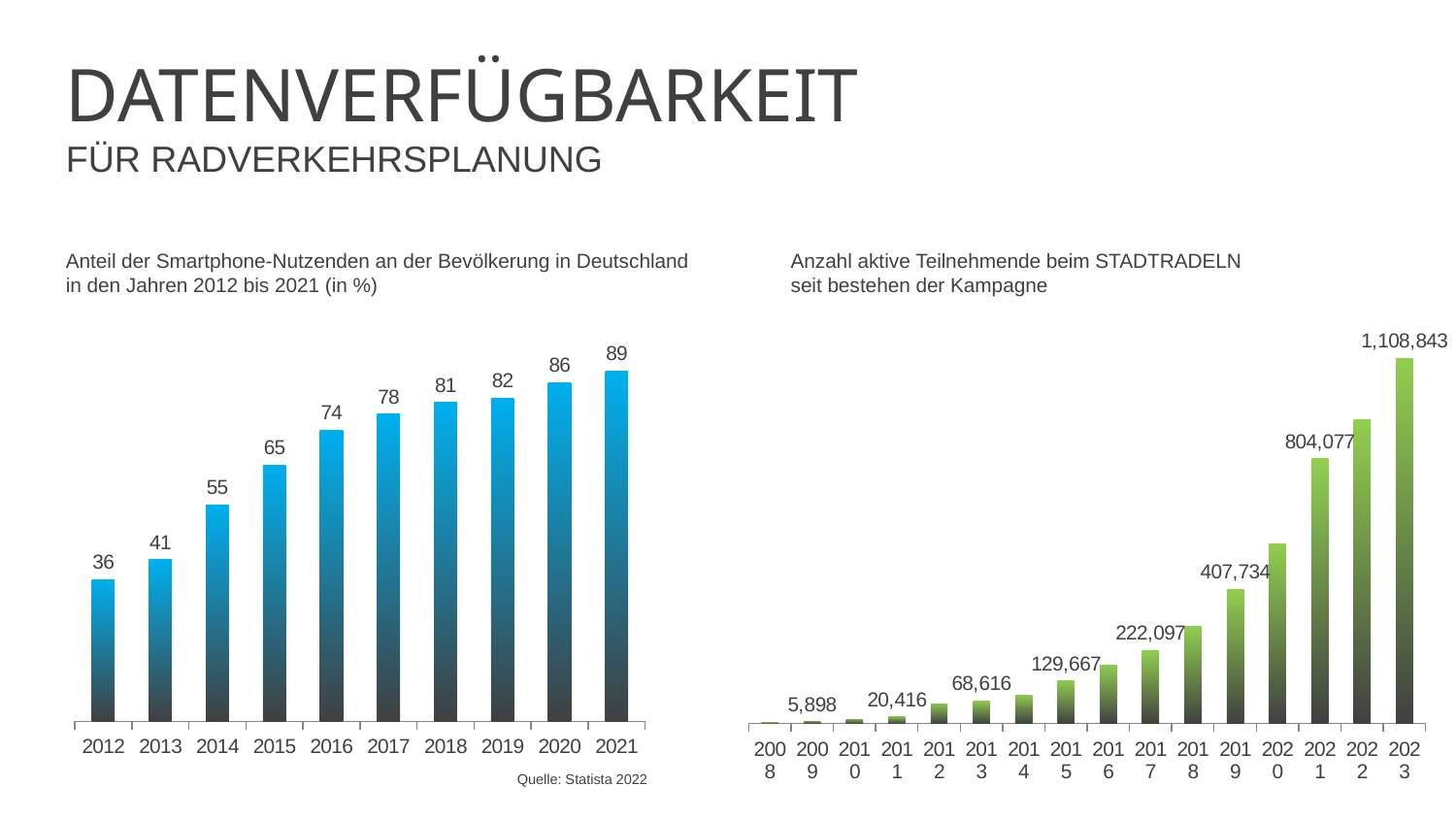
What kind of chart is the right chart (Anzahl aktive Teilnehmende beim STADTRADELN)? bar chart In the right chart (Anzahl aktive Teilnehmende beim STADTRADELN), what is the value for 2021? 804,077 In the left chart (Anteil der Smartphone-Nutzenden), do the values rise or fall from 2012 to 2021? rise In the left chart (Anteil der Smartphone-Nutzenden), which year has the highest value? 2021 In the left chart (Anteil der Smartphone-Nutzenden), what is the value for 2017? 78 In the left chart (Anteil der Smartphone-Nutzenden), what is the difference between the values for 2021 and 2012? 53 In the right chart (Anzahl aktive Teilnehmende beim STADTRADELN), how many years are shown on the x axis? 16 In the left chart (Anteil der Smartphone-Nutzenden), which year has the lowest value? 2012 In the right chart (Anzahl aktive Teilnehmende beim STADTRADELN), what is the value for 2023? 1,108,843 In the left chart (Anteil der Smartphone-Nutzenden), what is the value for 2012? 36 In the left chart (Anteil der Smartphone-Nutzenden), how many years are shown on the x axis? 10 In the right chart (Anzahl aktive Teilnehmende beim STADTRADELN), which year has the highest value? 2023